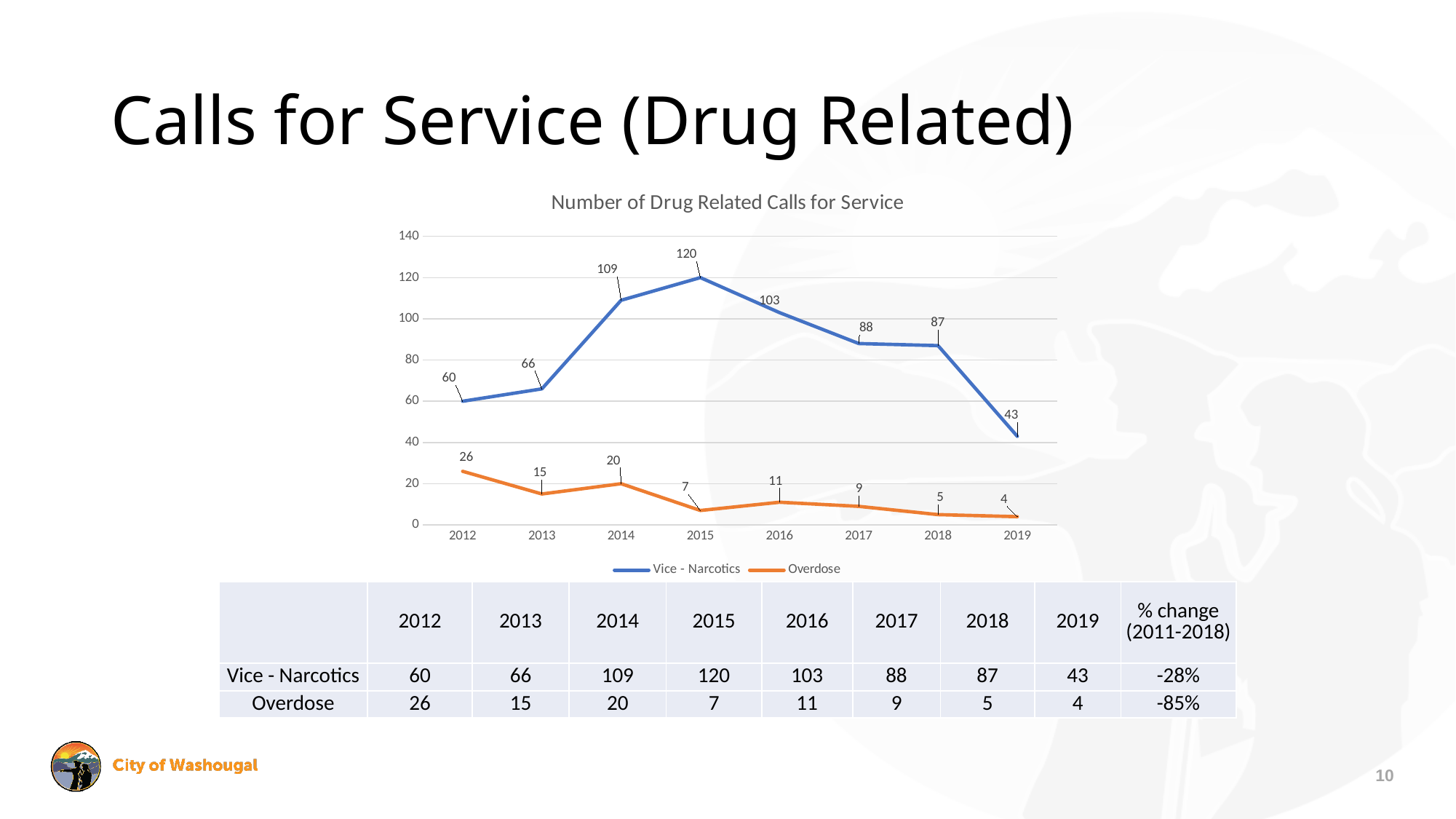
What is the difference between Vice - Narcotics and Overdose in 2014? 89 What is the value for Overdose in 2012? 26 How many series does the legend list? 2 What is the title of the chart? Number of Drug Related Calls for Service In which year is the Overdose series lowest? 2019 In which year is the Vice - Narcotics series highest? 2015 Which is larger, Vice - Narcotics in 2018 or Vice - Narcotics in 2019? Vice - Narcotics in 2018 What is the value for Vice - Narcotics in 2015? 120 How many years are plotted on the x axis? 8 Is the value for Vice - Narcotics in 2016 greater or less than 100? greater What kind of chart is shown? line chart What is the value for Vice - Narcotics in 2019? 43